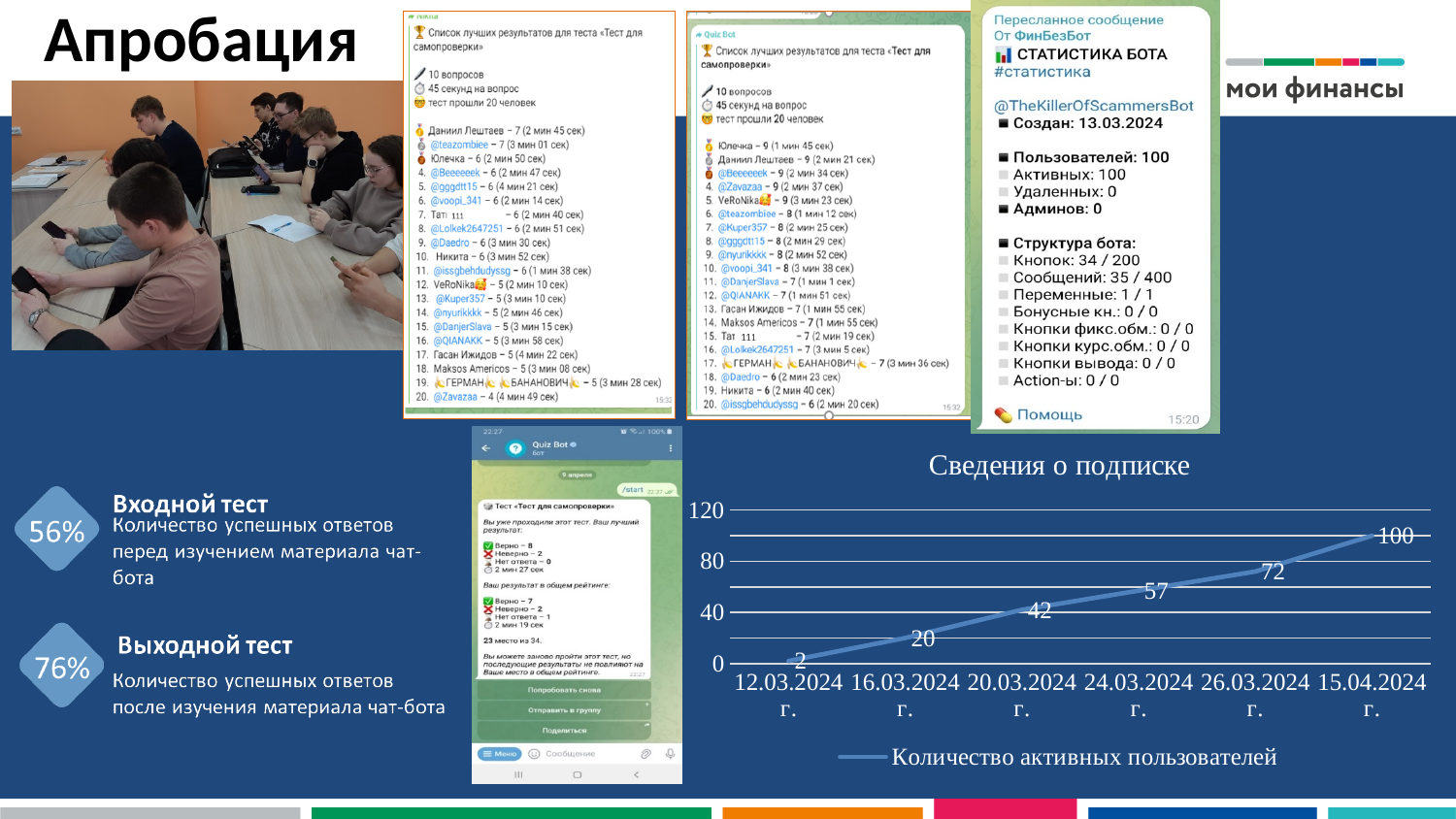
What is the value for 12.03.2024 г. in the "Сведения о подписке" chart? 2 What is the difference between the values for 26.03.2024 г. and 24.03.2024 г. in the "Сведения о подписке" chart? 15 Which date has the highest value in the "Сведения о подписке" chart? 15.04.2024 г. In the "Сведения о подписке" chart, which is larger: the value for 16.03.2024 г. or the value for 20.03.2024 г.? 20.03.2024 г. Which date has the lowest value in the "Сведения о подписке" chart? 12.03.2024 г. What type of chart is shown under the title "Сведения о подписке"? line chart Do the values in the "Сведения о подписке" chart rise or fall from left to right? rise Is the value for 24.03.2024 г. in the "Сведения о подписке" chart greater or less than 40? greater What is the value for 15.04.2024 г. in the "Сведения о подписке" chart? 100 What is the legend entry of the series in the "Сведения о подписке" chart? Количество активных пользователей How many data points are plotted in the "Сведения о подписке" chart? 6 What is the value for 20.03.2024 г. in the "Сведения о подписке" chart? 42